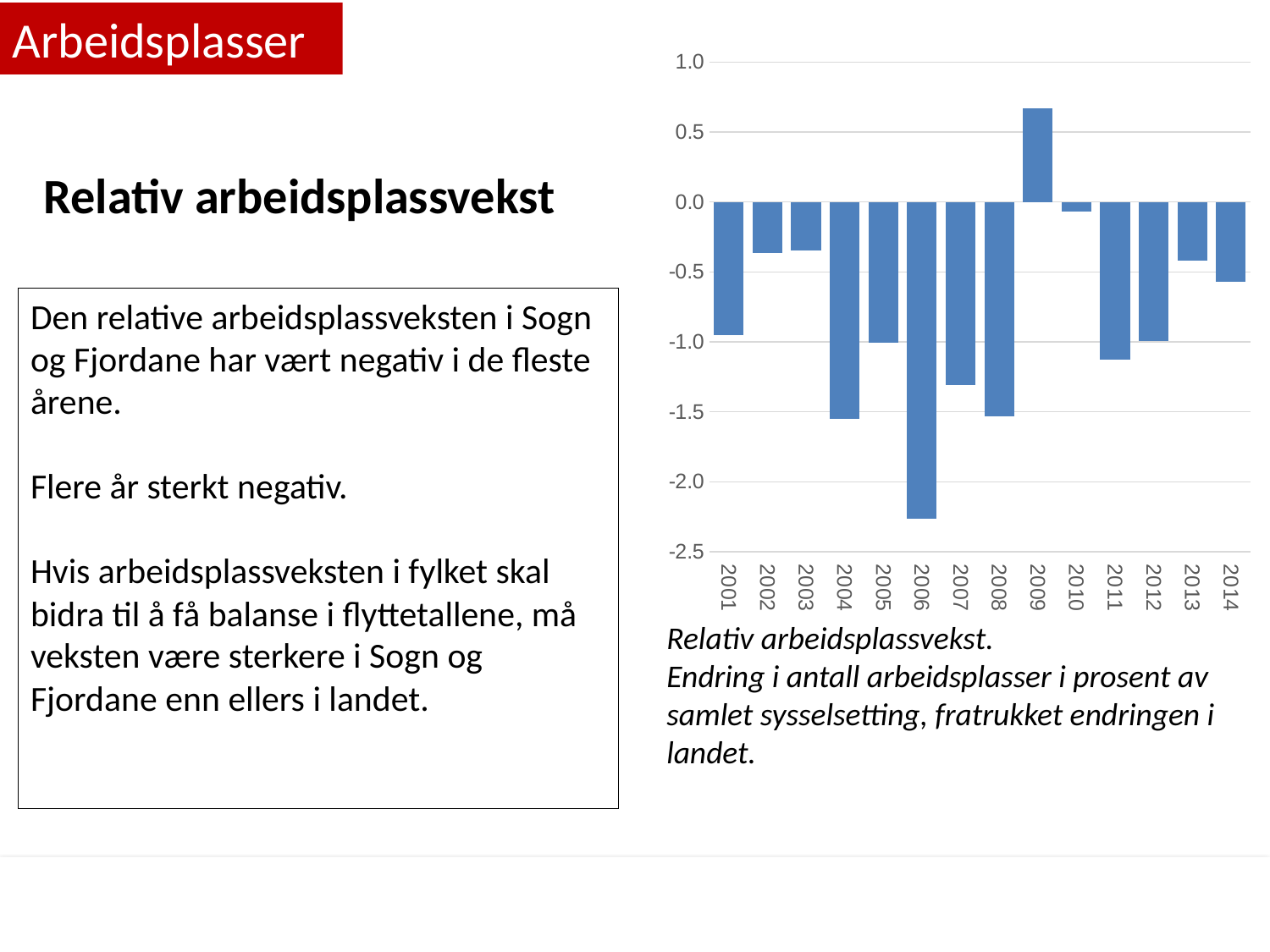
How many years in the chart have a positive value? 1 How many years are shown on the x axis of the chart? 14 What kind of chart is shown on the slide? bar chart Is the value for 2006 greater or less than -2.0? less Which year has the highest value in the chart? 2009 Which year has the lower value, 2004 or 2007? 2004 Is the value for 2002 greater or less than -0.5? greater Is the value for 2007 greater or less than -1.0? less Which year has the lowest value in the chart? 2006 What is the first line of the caption below the chart? Relativ arbeidsplassvekst.